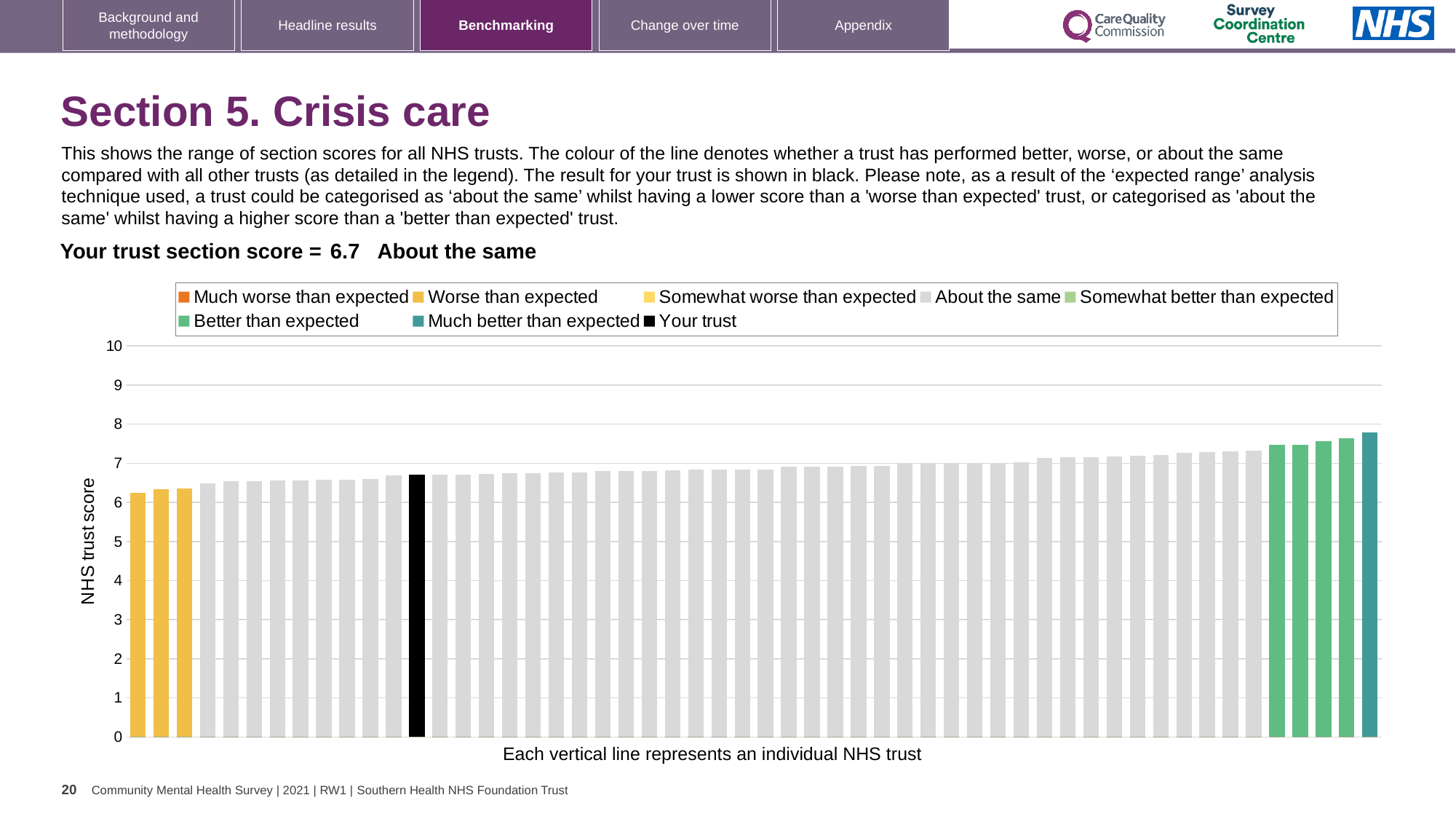
What kind of chart is shown on the slide? bar chart What is the label on the vertical axis of the chart? NHS trust score Is the value of the tallest bar in the chart greater or less than 8? less Is the value of the shortest bar in the chart greater or less than 6? greater Is the black bar for your trust higher or lower than the rightmost bar? lower What does each vertical line in the chart represent, according to the x-axis label? an individual NHS trust Which category is your trust placed in for this section? About the same How many bars are coloured as 'Worse than expected' (yellow)? 3 What is the section score for your trust shown on the slide? 6.7 How many entries does the chart legend list? 8 Is the value of the black bar (your trust) greater or less than 5? greater Do the bar values rise or fall from left to right along the x axis? rise